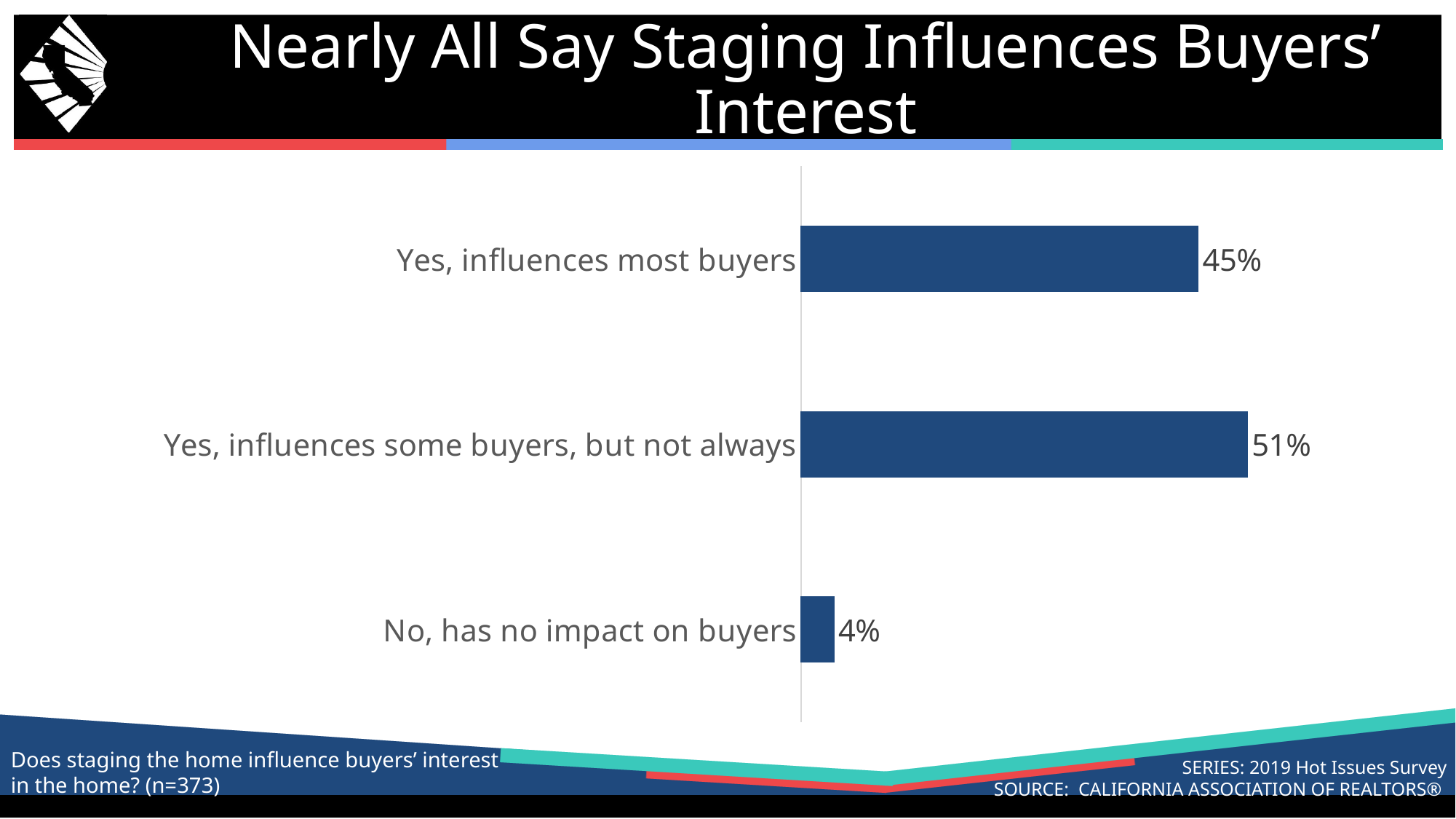
What percentage of respondents said staging influences most buyers? 45% What is the combined percentage of respondents who said staging influences buyers in some way (the two 'Yes' categories)? 96% What percentage of respondents said staging has no impact on buyers? 4% How many response categories are shown in the chart? 3 Which response category has the lowest percentage? No, has no impact on buyers What type of chart is shown on the slide? Bar chart What is the sample size (n) of the survey question shown on the slide? 373 What is the difference in percentage points between 'Yes, influences some buyers, but not always' and 'Yes, influences most buyers'? 6 percentage points What percentage of respondents said staging influences some buyers, but not always? 51% What is the difference in percentage points between 'Yes, influences most buyers' and 'No, has no impact on buyers'? 41 percentage points Which response category has the highest percentage? Yes, influences some buyers, but not always Which is larger: the share saying staging influences most buyers or the share saying it influences some buyers, but not always? Yes, influences some buyers, but not always